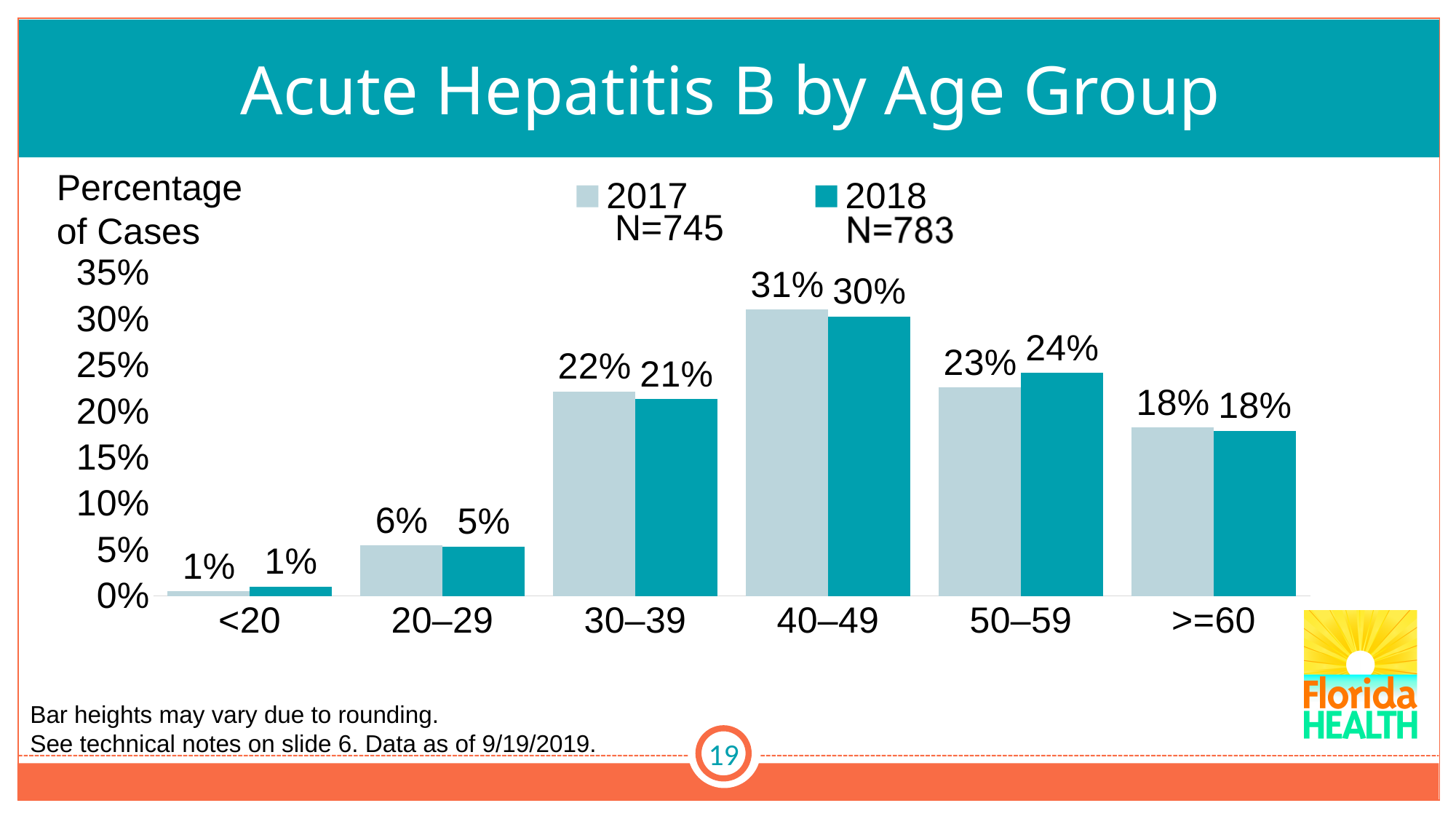
What is the difference between the 2017 and 2018 percentages for the 30–39 age group? 1% What percentage of cases were in the 40–49 age group in 2017? 31% Which age group had the highest percentage of cases in 2018? 40–49 How many age groups are shown on the x axis? 6 What is the title of the chart? Acute Hepatitis B by Age Group What percentage of cases were in the 50–59 age group in 2018? 24% Which age group had the lowest percentage of cases in 2017? <20 Which is larger for the 50–59 age group: the 2017 value or the 2018 value? 2018 How many series does the legend list? 2 What kind of chart is shown on the slide? Bar chart What is the N value shown in the legend for 2018? N=783 What percentage of cases were in the 20–29 age group in 2018? 5%